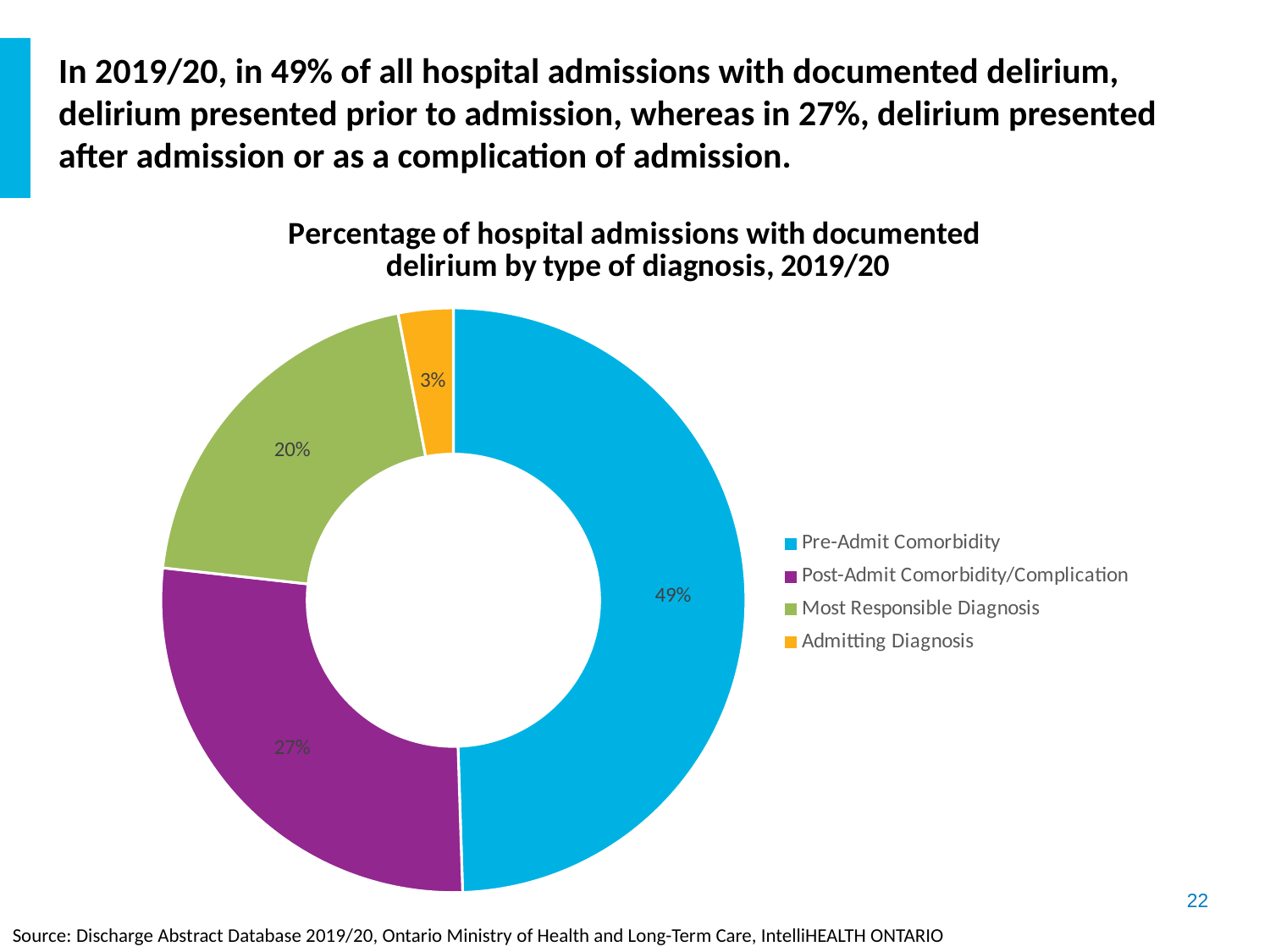
Which is larger: the share for Most Responsible Diagnosis or the share for Admitting Diagnosis? Most Responsible Diagnosis Which type of diagnosis has the smallest share of hospital admissions with documented delirium? Admitting Diagnosis What kind of chart is shown on the slide? Pie chart (doughnut) What percentage of hospital admissions with documented delirium had delirium as a Post-Admit Comorbidity/Complication? 27% What percentage of hospital admissions with documented delirium had delirium as the Admitting Diagnosis? 3% How many types of diagnosis are shown in the chart? 4 Which type of diagnosis has the largest share of hospital admissions with documented delirium? Pre-Admit Comorbidity What is the title of the chart? Percentage of hospital admissions with documented delirium by type of diagnosis, 2019/20 What colour represents Post-Admit Comorbidity/Complication in the chart? Purple What percentage of hospital admissions with documented delirium had delirium as a Pre-Admit Comorbidity? 49% What percentage of hospital admissions with documented delirium had delirium as the Most Responsible Diagnosis? 20% What is the difference in percentage points between Pre-Admit Comorbidity and Post-Admit Comorbidity/Complication? 22 percentage points